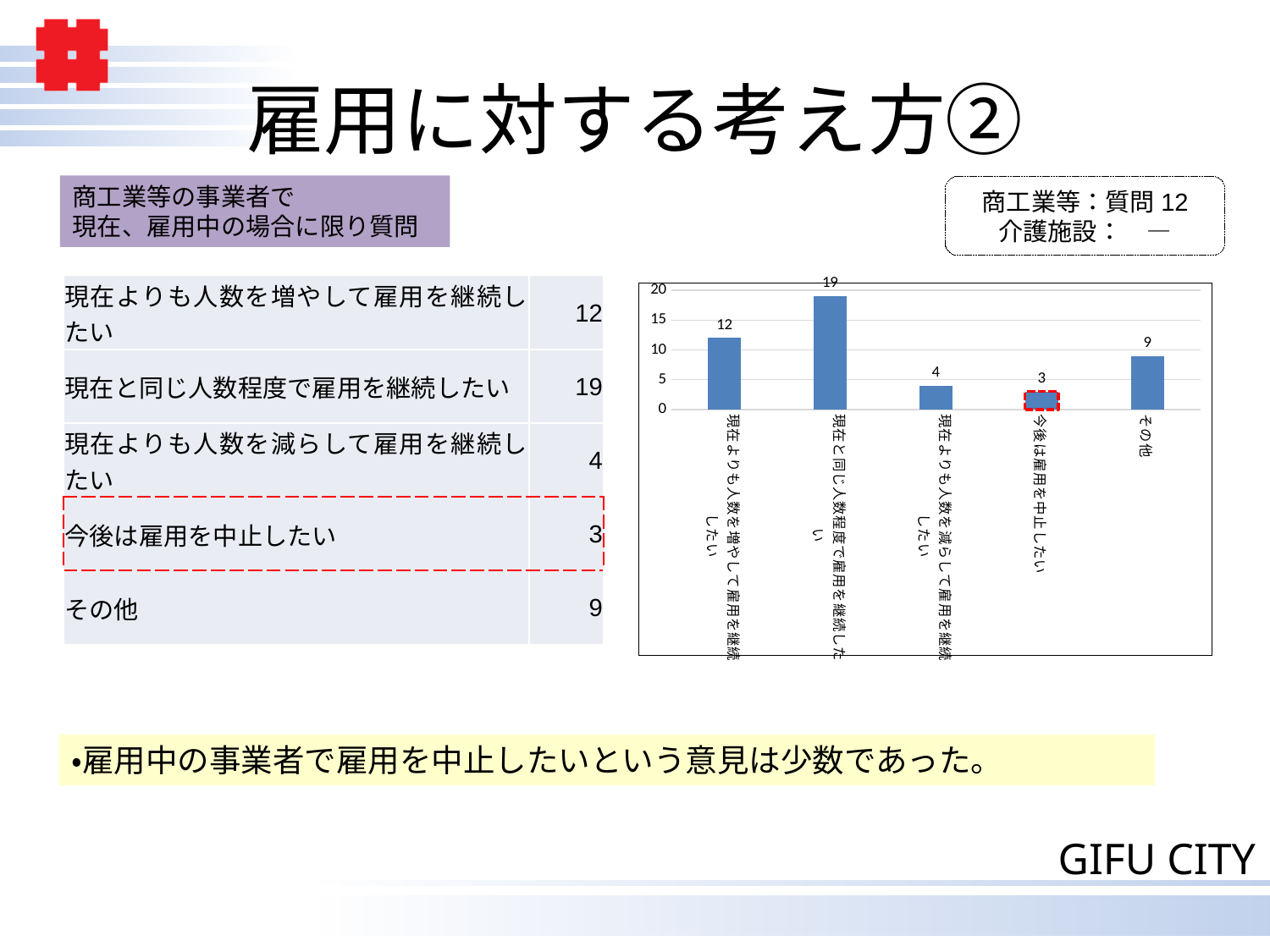
Which is larger, the value for その他 or the value for 現在よりも人数を減らして雇用を継続したい? その他 What is the value for 現在よりも人数を減らして雇用を継続したい? 4 What is the value for 今後は雇用を中止したい? 3 Is the value for 現在よりも人数を増やして雇用を継続したい greater or less than 10? greater What is the value for その他? 9 What is the difference between the values for 現在と同じ人数程度で雇用を継続したい and 現在よりも人数を増やして雇用を継続したい? 7 What is the total of all five values shown in the chart? 47 Which category has the lowest value? 今後は雇用を中止したい What is the value for 現在と同じ人数程度で雇用を継続したい? 19 What kind of chart is shown on the slide? bar chart How many categories are shown in the chart? 5 Which category has the highest value? 現在と同じ人数程度で雇用を継続したい